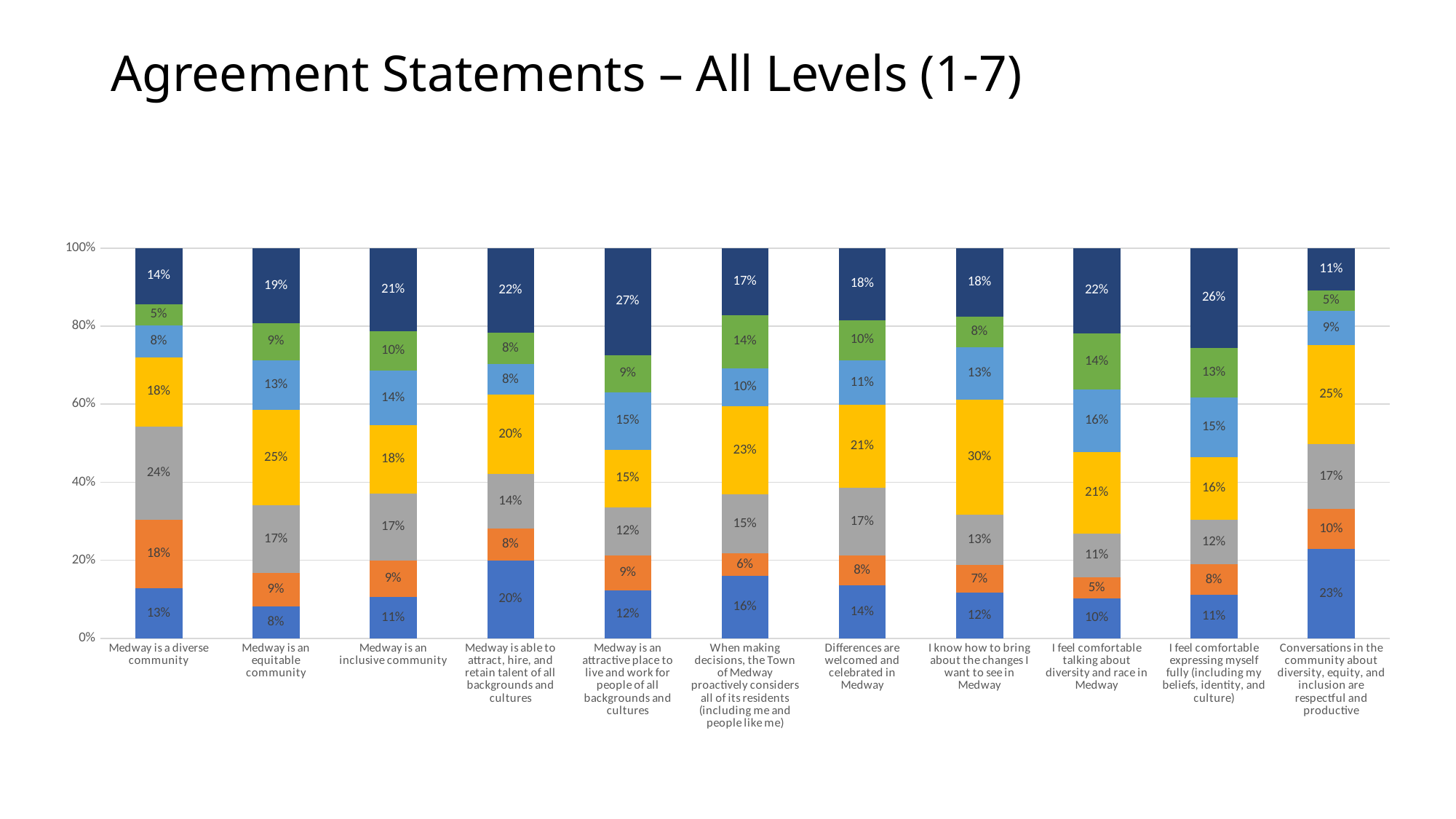
What is the value of the bottom (blue) segment for 'Medway is able to attract, hire, and retain talent of all backgrounds and cultures'? 20% Which statement has the smallest top (dark blue) segment? Conversations in the community about diversity, equity, and inclusion are respectful and productive Which statement has the largest bottom (blue) segment? Conversations in the community about diversity, equity, and inclusion are respectful and productive Which has the larger gray segment: 'Medway is a diverse community' or 'Medway is an equitable community'? Medway is a diverse community What is the difference between the top (dark blue) segment for 'I feel comfortable expressing myself fully (including my beliefs, identity, and culture)' and that for 'Medway is a diverse community'? 12 percentage points Which statement has the largest yellow segment? I know how to bring about the changes I want to see in Medway What is the value of the top (dark blue) segment for 'Medway is an attractive place to live and work for people of all backgrounds and cultures'? 27% How many agreement statements (categories) are shown along the x axis? 11 What is the value of the yellow segment for 'I know how to bring about the changes I want to see in Medway'? 30% What kind of chart is shown on the slide? Stacked bar chart How many stacked segments make up each bar? 7 What is the value of the orange segment for 'I feel comfortable talking about diversity and race in Medway'? 5%